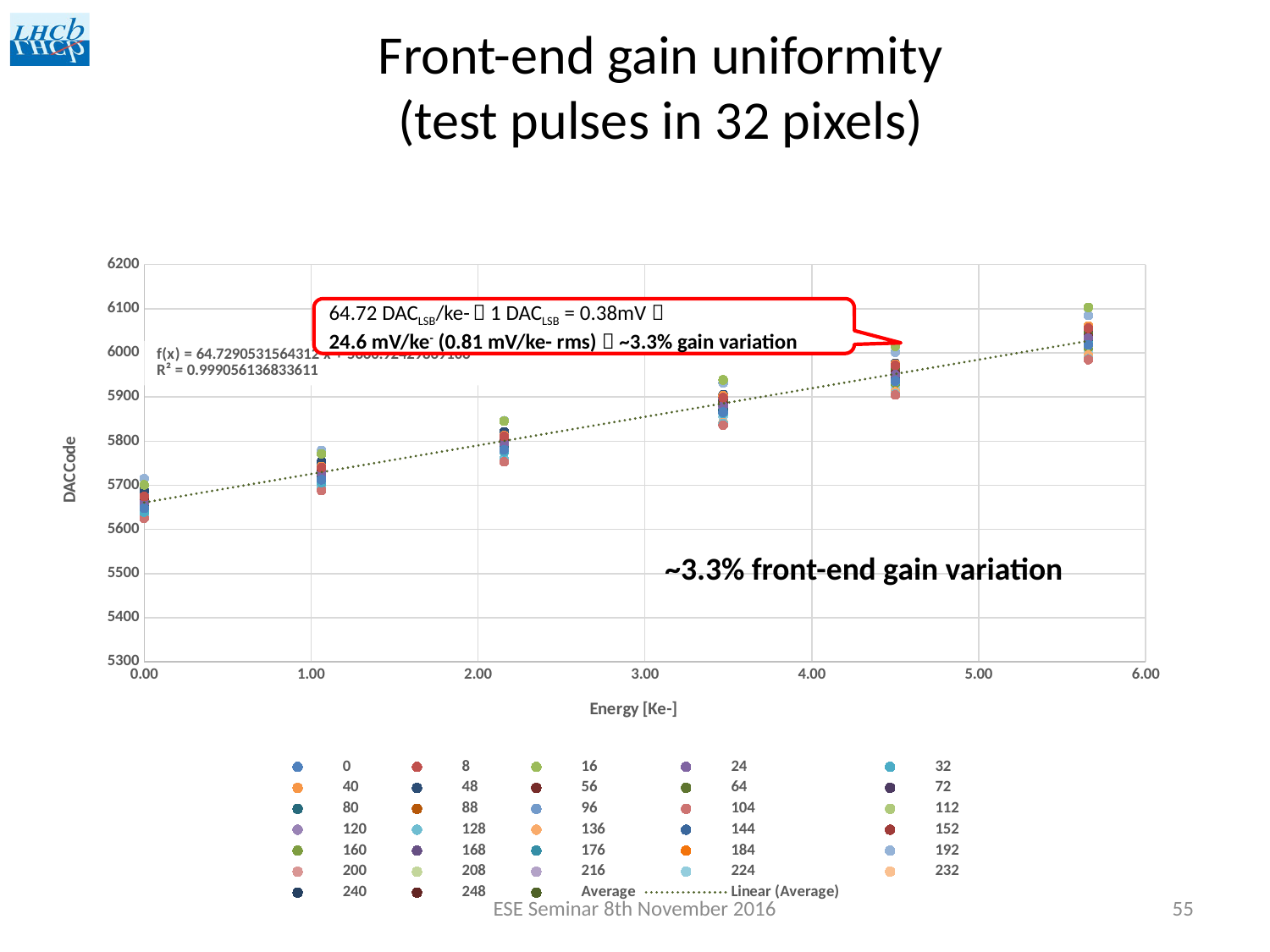
How many distinct energy points (clusters of data points) are plotted along the x axis? 6 Which energy point has the highest DACCode values, the one at 0.00 or the one around 5.65 Ke-? the one around 5.65 Ke- What is the R² value printed on the chart for the linear fit? 0.999056136833611 Are the DACCode values at the energy point around 1.05 Ke- greater or less than 5900? less What kind of chart is shown on the slide? scatter chart Are the DACCode values at the energy point around 3.5 Ke- greater or less than 5800? greater How many entries does the chart legend list? 34 Are the DACCode values at the highest energy point (around 5.65 Ke-) greater or less than 5900? greater What is the label of the x axis of the chart? Energy [Ke-] Do the DACCode values rise or fall as Energy increases along the x axis? rise